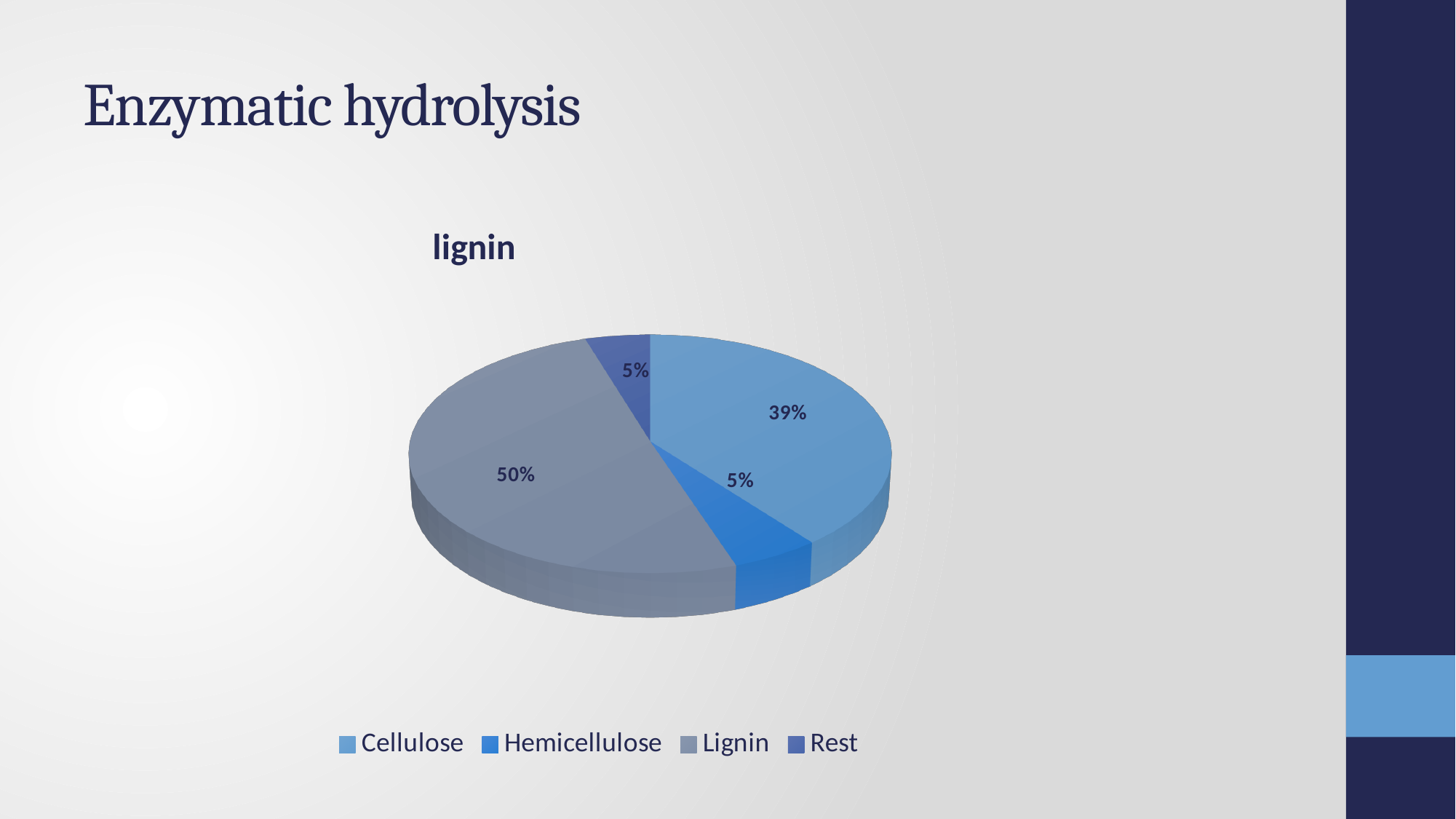
What percentage of the pie does Lignin account for? 50% How many categories does the legend list? 4 What kind of chart is shown on the slide? pie chart What share of the pie do Hemicellulose and Rest make up together? 10% Which category has the largest slice of the pie? Lignin What is the difference in percentage points between the Lignin slice and the Cellulose slice? 11 What percentage of the pie does Cellulose account for? 39% What percentage of the pie does Rest account for? 5% Which is larger, the Cellulose slice or the Lignin slice? Lignin What percentage of the pie does Hemicellulose account for? 5% What is the title of the chart? lignin Which is larger, the Cellulose slice or the Hemicellulose slice? Cellulose